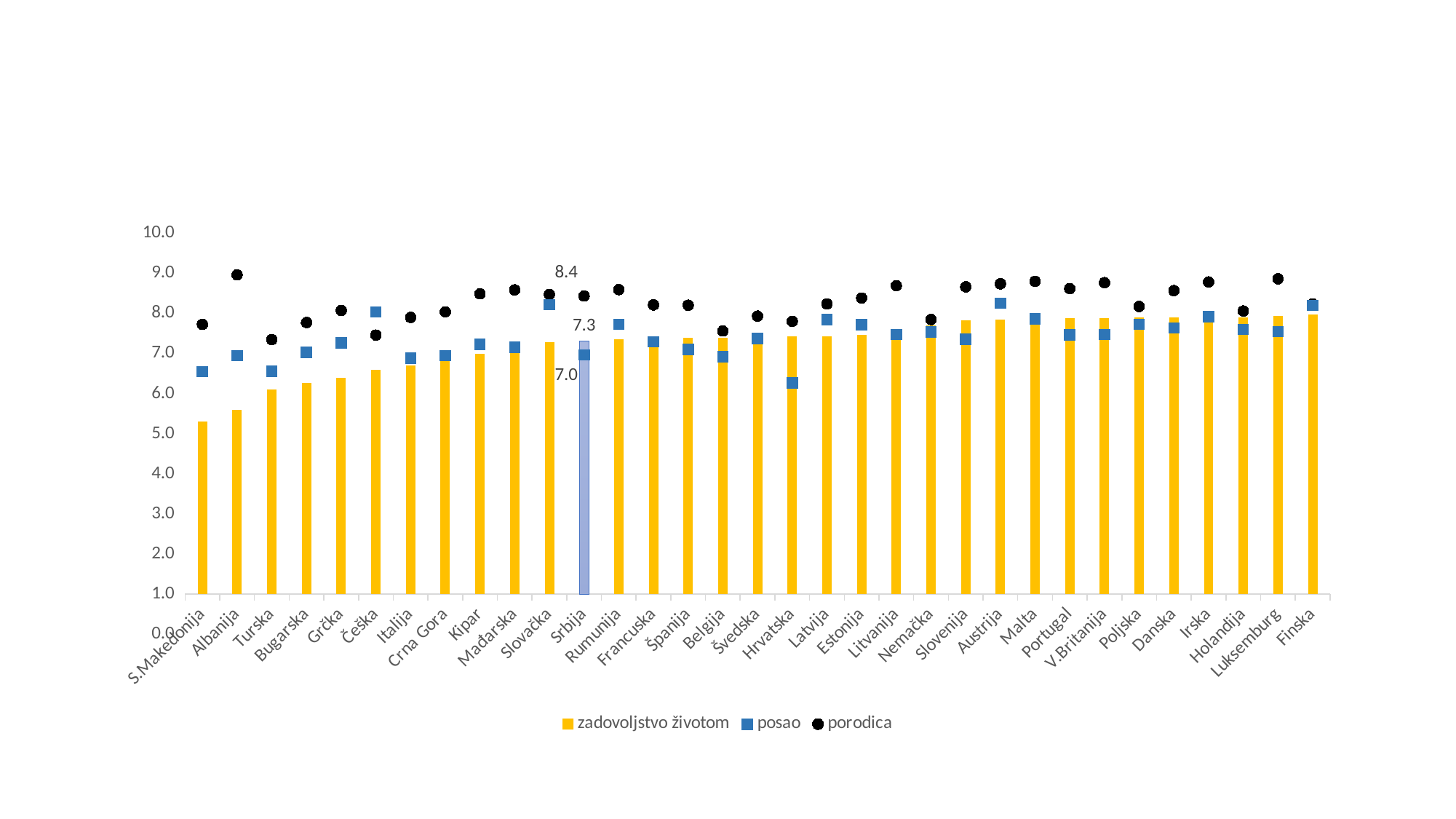
Which is larger, the zadovoljstvo životom value for Srbija or for S.Makedonija? Srbija Is the zadovoljstvo životom value for S.Makedonija greater or less than 6.0? less What is the posao value for Srbija? 7.0 How many series does the legend list? 3 What is the zadovoljstvo životom value for Srbija? 7.3 Is the porodica value for Albanija greater or less than 8.0? greater Which country has the lowest posao value? Hrvatska What is the value of the porodica series for Srbija? 8.4 How many countries are shown on the x axis? 33 For Srbija, what is the difference between the porodica value and the posao value? 1.4 Do the zadovoljstvo životom bars generally rise or fall from left to right? rise Which country has the lowest zadovoljstvo životom bar? S.Makedonija